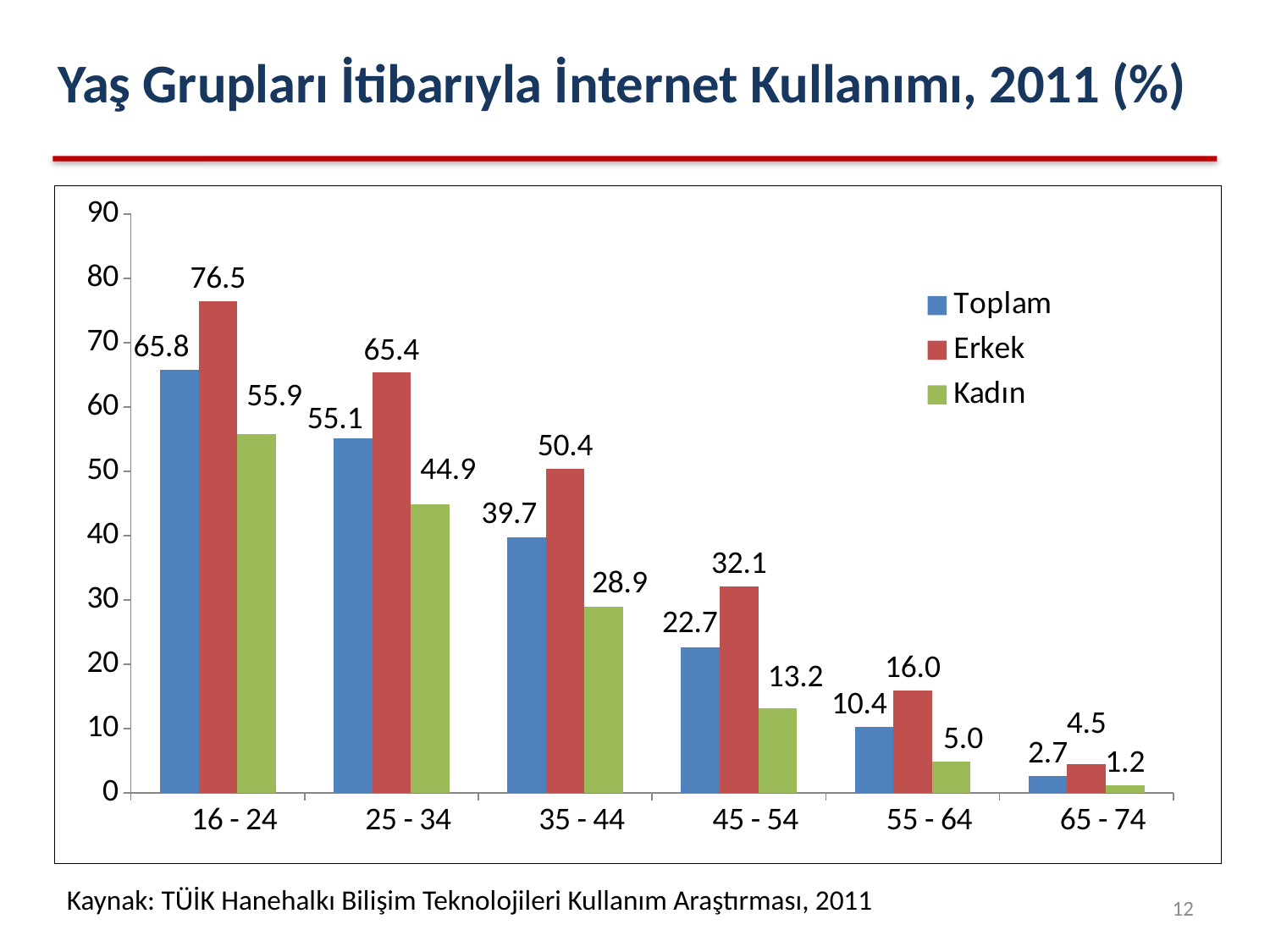
Do the Erkek values rise or fall as the age groups increase along the x axis? Fall Which age group has the lowest Kadın value? 65 - 74 What colour represents the Kadın series in the chart? Green What is the Kadın value for the 35 - 44 age group? 28.9 How many series does the legend list? 3 What kind of chart is shown on the slide? Bar chart What is the difference between the Erkek and Kadın values for the 25 - 34 age group? 20.5 What is the Toplam value for the 55 - 64 age group? 10.4 What is the Erkek value for the 16 - 24 age group? 76.5 Which is larger: the Toplam value for 45 - 54 or the Kadın value for 35 - 44? Kadın value for 35 - 44 How many age groups are shown on the x axis? 6 Which age group has the highest Toplam value? 16 - 24